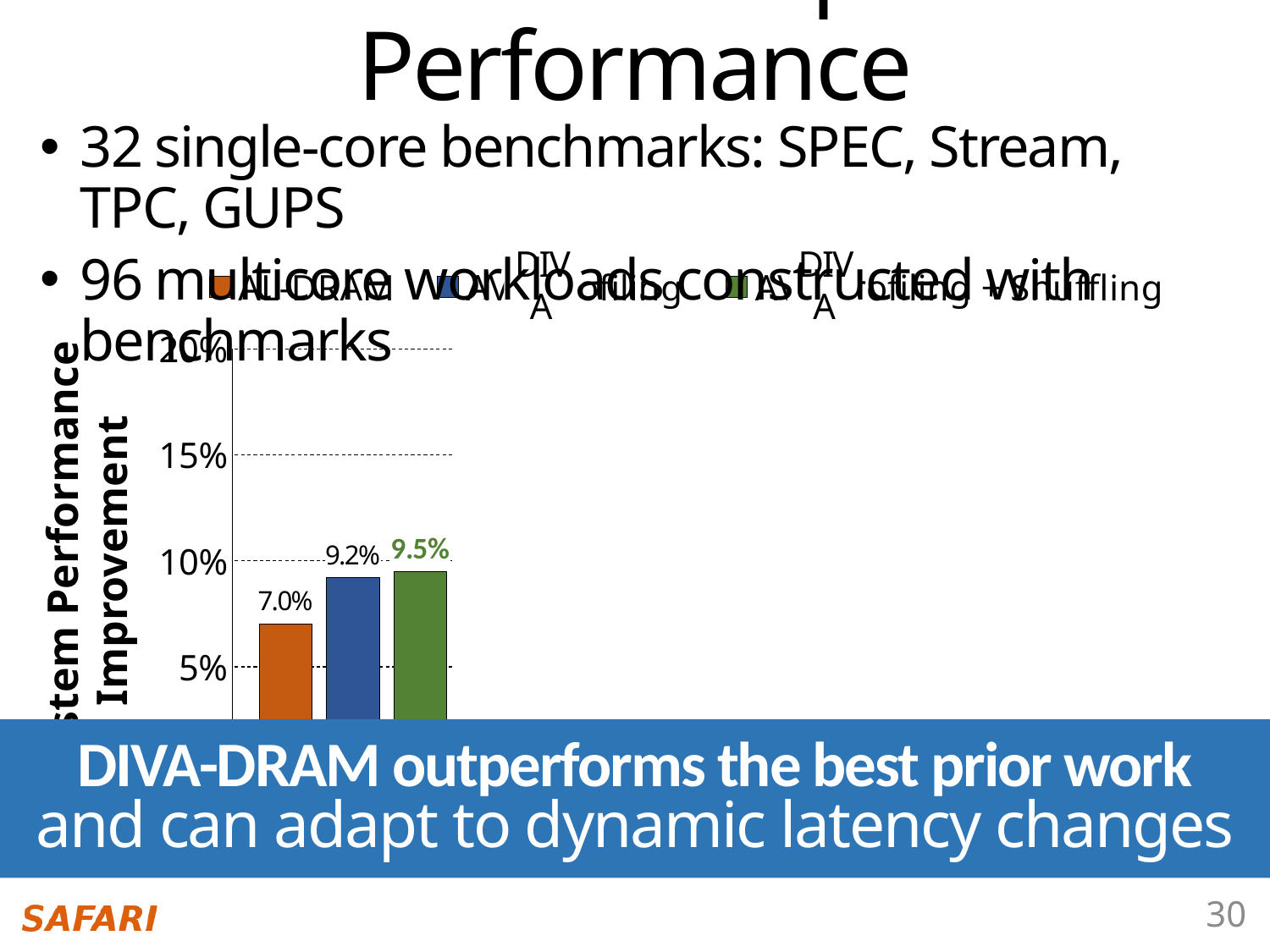
What is the value of the orange bar in the chart? 7.0% How many bars are plotted in the chart? 3 Do the bar values rise or fall from left to right? rise What type of chart is shown on the slide? bar chart What is the value of the blue bar in the chart? 9.2% What is the difference between the green bar and the orange bar? 2.5% What is the difference between the blue bar and the orange bar? 2.2% What is the value of the green bar in the chart? 9.5% Is the value of the orange bar greater or less than 10%? less Which bar has the lowest value in the chart? the orange bar (7.0%) Which is larger, the blue bar or the orange bar? the blue bar Which bar has the highest value in the chart? the green bar (9.5%)